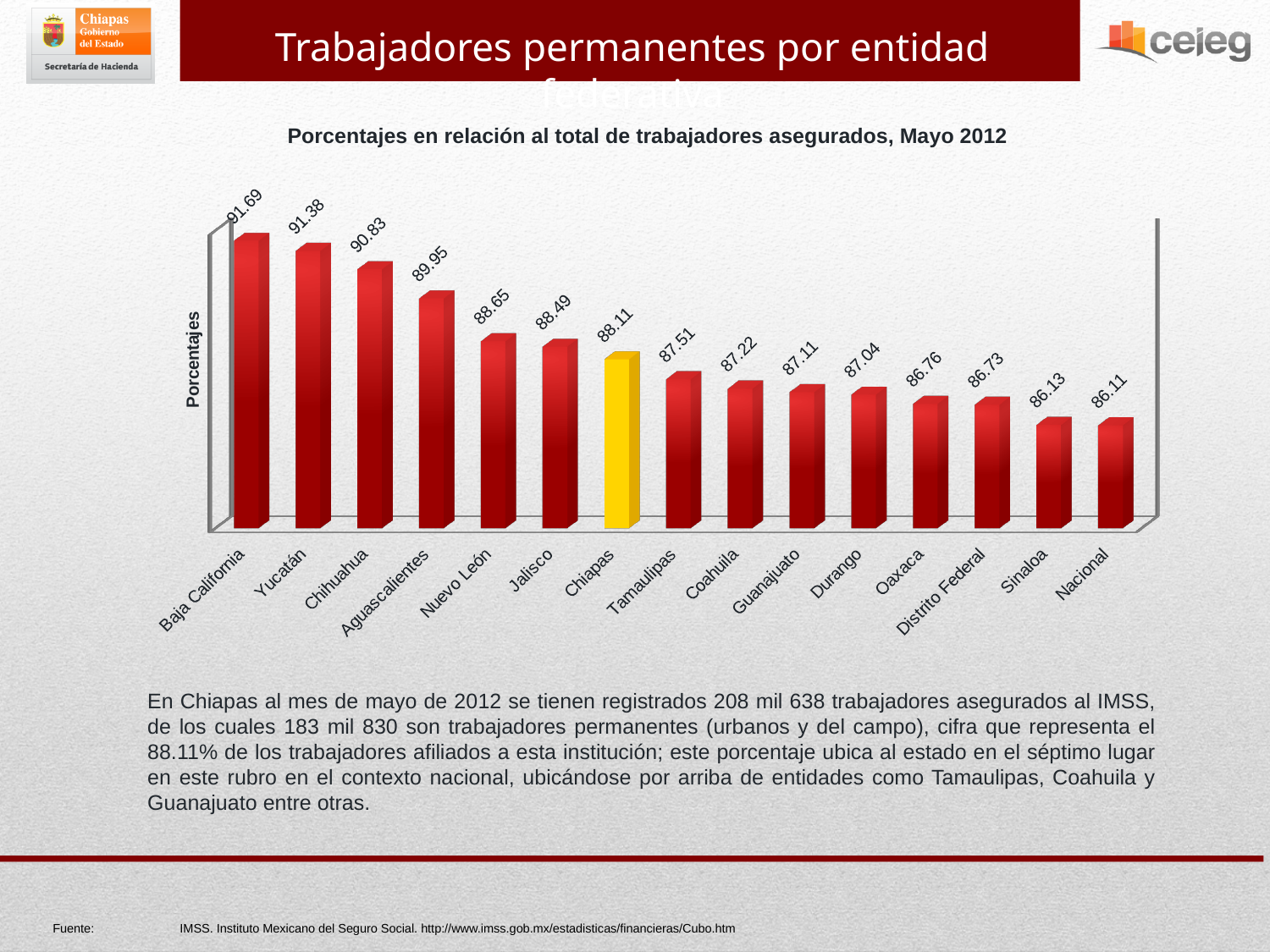
Which bar is highlighted in yellow? Chiapas Which category has the lowest value? Nacional What is the value for Baja California? 91.69 What is the value for Distrito Federal? 86.73 Which category has the highest value? Baja California What is the value for Chiapas? 88.11 What kind of chart is shown on the slide? Bar chart What is the value for Nacional? 86.11 What is the difference between the values for Baja California and Chiapas? 3.58 How many categories are shown on the x axis? 15 What is the difference between the values for Chiapas and Nacional? 2.00 Which is larger, the value for Yucatán or the value for Aguascalientes? Yucatán